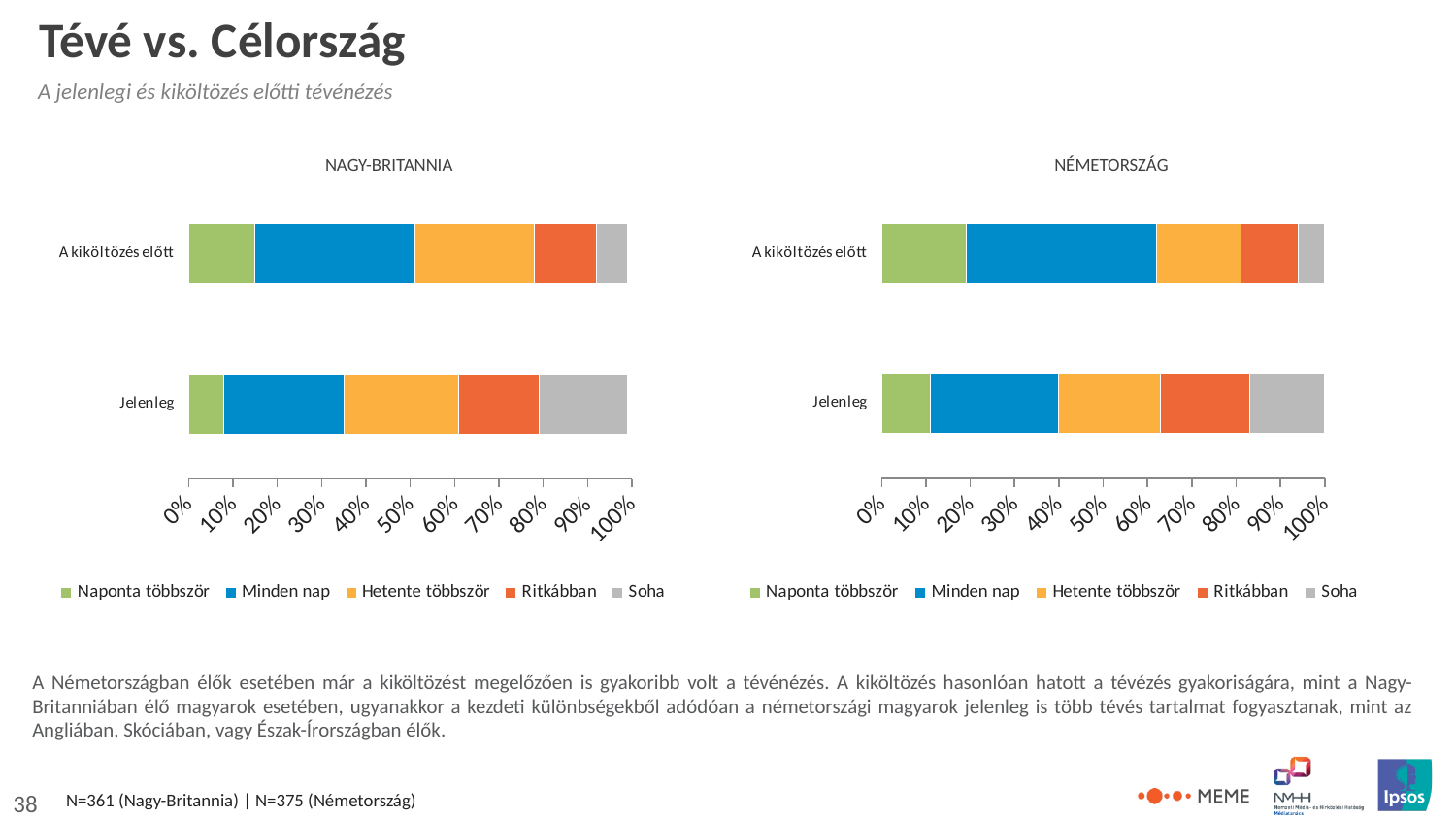
In the NAGY-BRITANNIA chart, is the 'Soha' share for 'Jelenleg' greater or less than 10%? greater In the NÉMETORSZÁG chart, is the 'Soha' share for 'A kiköltözés előtt' greater or less than 10%? less How many series does the legend of the NÉMETORSZÁG chart list? 5 What are the titles of the two charts on the slide? NAGY-BRITANNIA and NÉMETORSZÁG In the NÉMETORSZÁG chart, is the 'Minden nap' share for 'A kiköltözés előtt' greater or less than 30%? greater What kind of chart is used for the NAGY-BRITANNIA data? Stacked bar chart In the NAGY-BRITANNIA chart, which bar has the larger 'Soha' segment, 'A kiköltözés előtt' or 'Jelenleg'? Jelenleg In the NAGY-BRITANNIA chart, which legend entry is shown in green? Naponta többször In the NÉMETORSZÁG chart, which bar has the larger 'Naponta többször' segment, 'A kiköltözés előtt' or 'Jelenleg'? A kiköltözés előtt How many categories (bars) are shown in the NAGY-BRITANNIA chart? 2 In the NÉMETORSZÁG chart, which series has the largest segment in the 'A kiköltözés előtt' bar? Minden nap